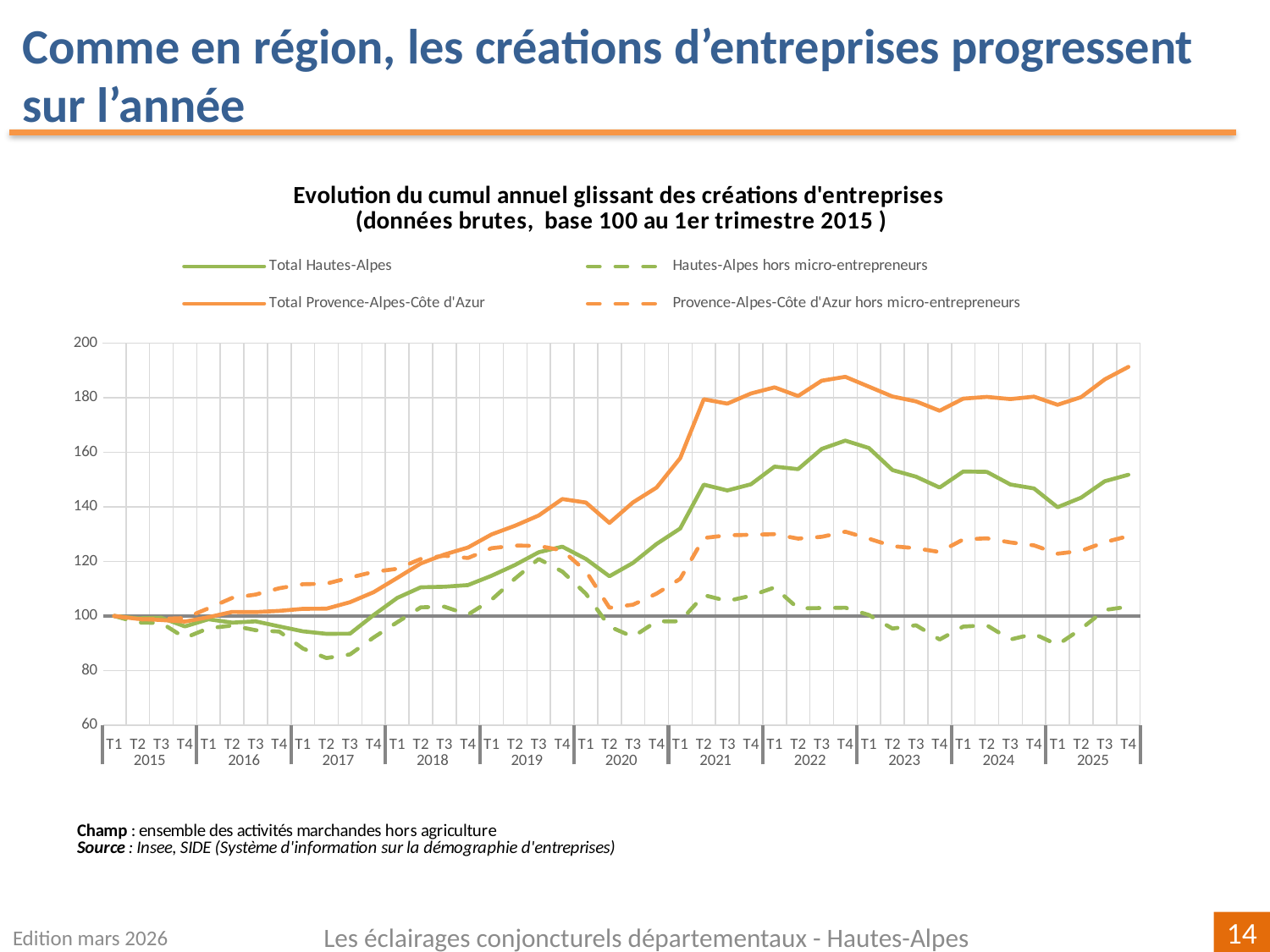
Is the value for Total Hautes-Alpes at T4 2025 greater or less than 140? greater What is the value of the Total Hautes-Alpes series at T1 2015? 100 What kind of chart is shown on the slide? line chart At T4 2025, which is larger: Total Provence-Alpes-Côte d'Azur or Total Hautes-Alpes? Total Provence-Alpes-Côte d'Azur Is the value for Provence-Alpes-Côte d'Azur hors micro-entrepreneurs at T4 2025 greater or less than 120? greater Which series is drawn as a dashed orange line? Provence-Alpes-Côte d'Azur hors micro-entrepreneurs How many years are shown along the x axis? 11 Which series has the highest value at T4 2025? Total Provence-Alpes-Côte d'Azur Is the value for Total Provence-Alpes-Côte d'Azur at T4 2025 greater or less than 180? greater How many series does the legend list? 4 Does the Total Provence-Alpes-Côte d'Azur series rise or fall overall from T1 2015 to T4 2025? rise